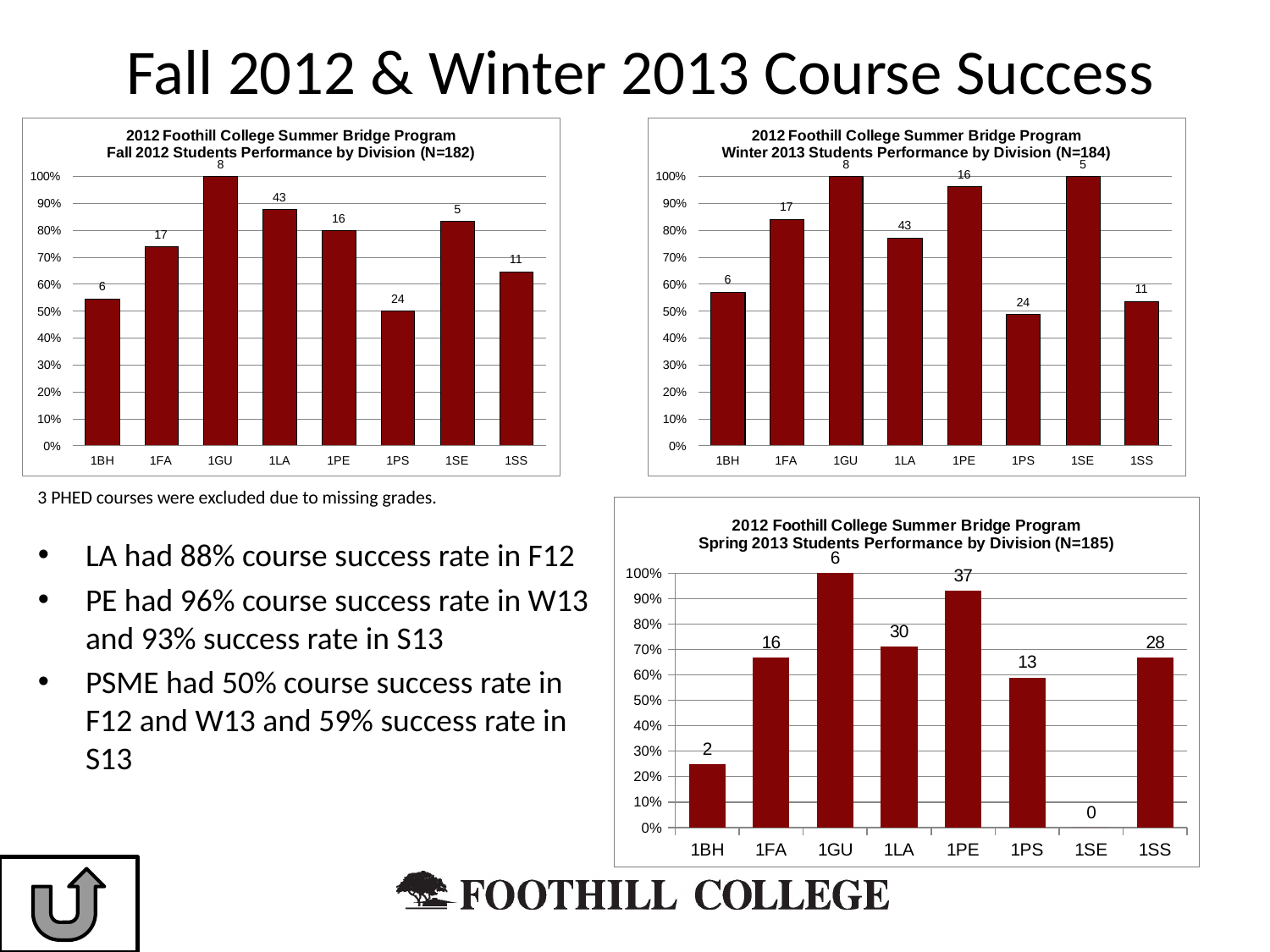
In the Spring 2013 Students Performance by Division chart, what number is printed above the 1PE bar? 37 How many divisions are shown on the x axis of the Fall 2012 Students Performance by Division chart? 8 What kind of chart is the Fall 2012 Students Performance by Division chart (top left)? bar chart In the Winter 2013 Students Performance by Division chart, which division has the lowest bar? 1PS In the Fall 2012 Students Performance by Division chart, is the value for 1BH greater or less than 60%? less In the Spring 2013 Students Performance by Division chart, which division has the lowest bar? 1SE In the Fall 2012 Students Performance by Division chart, which division has the lowest bar? 1PS In the Winter 2013 Students Performance by Division chart, is the value for 1FA greater or less than 80%? greater In the Winter 2013 Students Performance by Division chart, what number is printed above the 1PE bar? 16 In the Fall 2012 Students Performance by Division chart, what number is printed above the 1LA bar? 43 In the Spring 2013 Students Performance by Division chart, which bar is taller, 1BH or 1PS? 1PS In the Fall 2012 Students Performance by Division chart, which division has the highest bar? 1GU